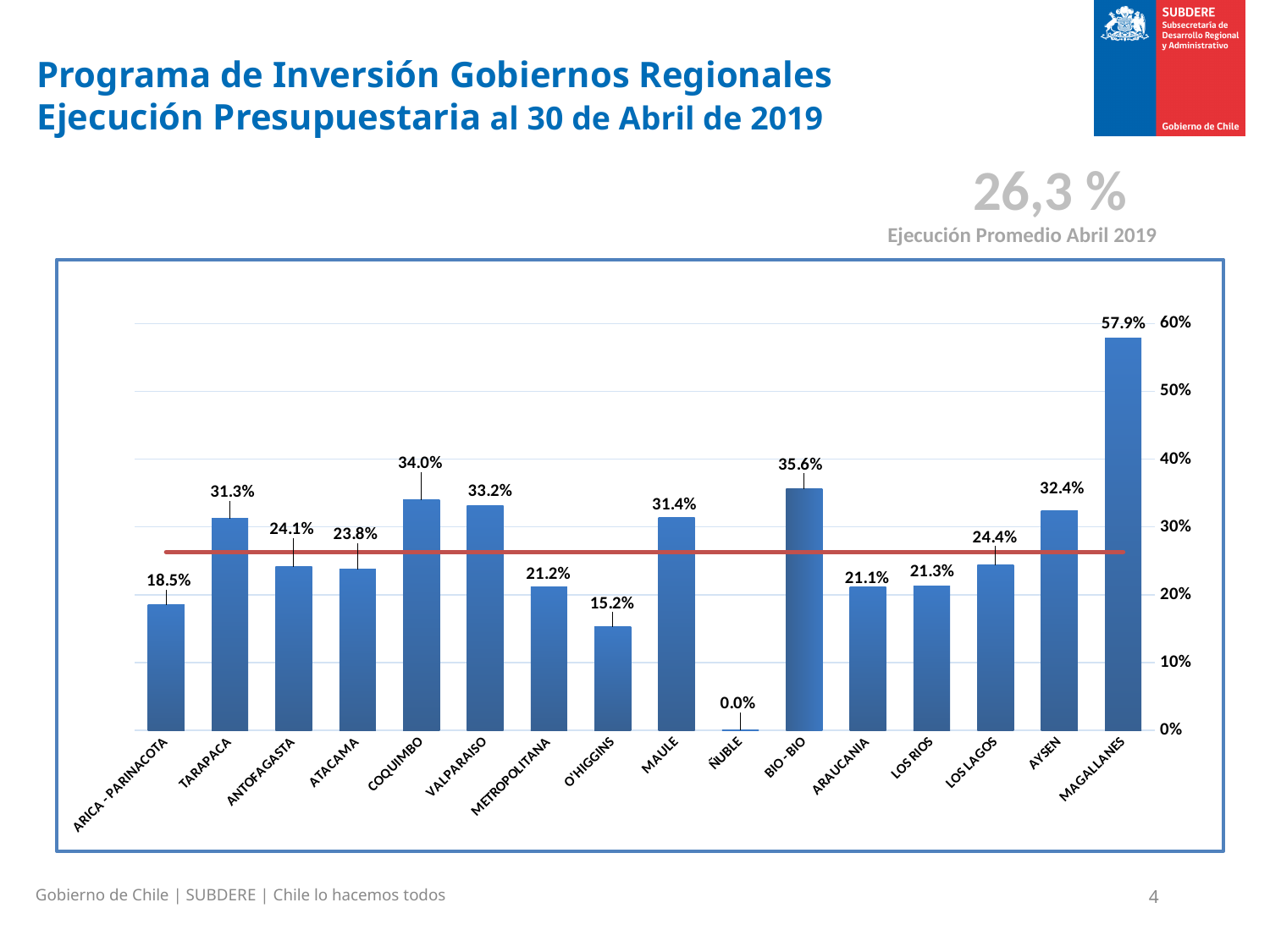
What is the value for COQUIMBO? 34.0% Which region has the lowest value? ÑUBLE Which is larger, the value for TARAPACA or the value for AYSEN? AYSEN Is the value for VALPARAISO greater or less than 30%? greater What is the difference between the values for MAGALLANES and ARICA - PARINACOTA? 39.4% What is the difference between the values for BIO-BIO and ARAUCANIA? 14.5% What is the value for MAGALLANES? 57.9% What kind of chart is shown on the slide? combination bar and line chart (bars with a horizontal average line) How many regions are shown on the x axis? 16 What average value does the red horizontal line on the chart represent, according to the slide? 26,3 % What is the value for O'HIGGINS? 15.2% Which region has the highest value? MAGALLANES